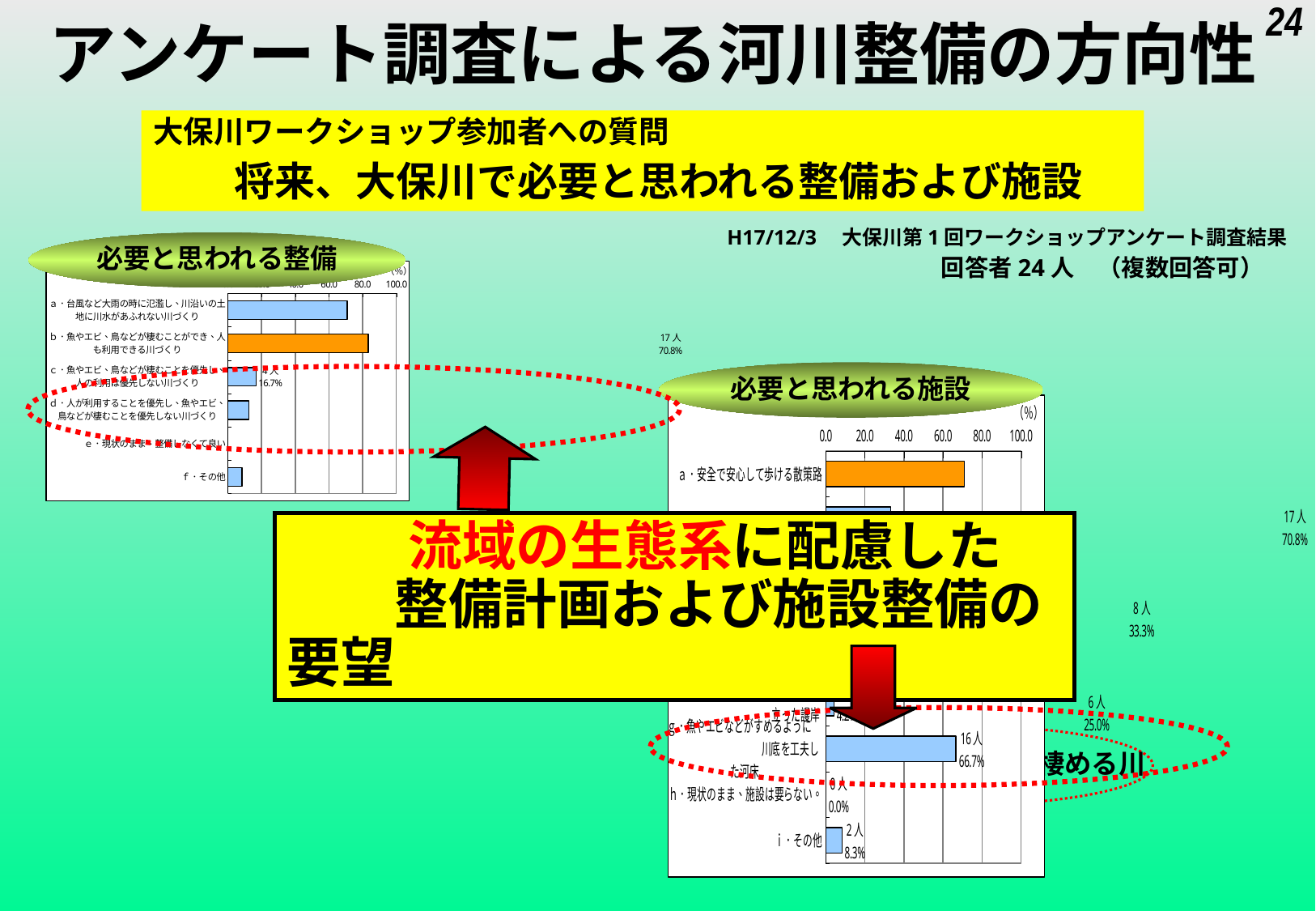
In the 必要と思われる施設 chart, what percentage is shown for h・現状のまま、施設は要らない? 0.0% In the 必要と思われる整備 chart, which category has the highest value? b・魚やエビ、鳥などが棲むことができ、人も利用できる川づくり In the 必要と思われる施設 chart, what percentage is shown for g・魚やエビなどがすめるように川底を工夫した河床? 66.7% In the 必要と思われる整備 chart, is the value for d・人が利用することを優先し、魚やエビ、鳥などが棲むことを優先しない川づくり greater or less than 20.0? less What kind of chart is the 必要と思われる施設 chart on the right? bar chart In the 必要と思われる施設 chart, which is larger, the value for g・魚やエビなどがすめるように川底を工夫した河床 or for i・その他? g・魚やエビなどがすめるように川底を工夫した河床 In the 必要と思われる施設 chart, how many more people chose g・魚やエビなどがすめるように川底を工夫した河床 than i・その他? 14人 In the 必要と思われる施設 chart, how many people chose g・魚やエビなどがすめるように川底を工夫した河床? 16人 What kind of chart is the 必要と思われる整備 chart on the left? bar chart In the 必要と思われる施設 chart, is the value for a・安全で安心して歩ける散策路 greater or less than 60.0? greater In the 必要と思われる施設 chart, what percentage is shown for i・その他? 8.3% How many categories are listed in the 必要と思われる整備 chart on the left? 6